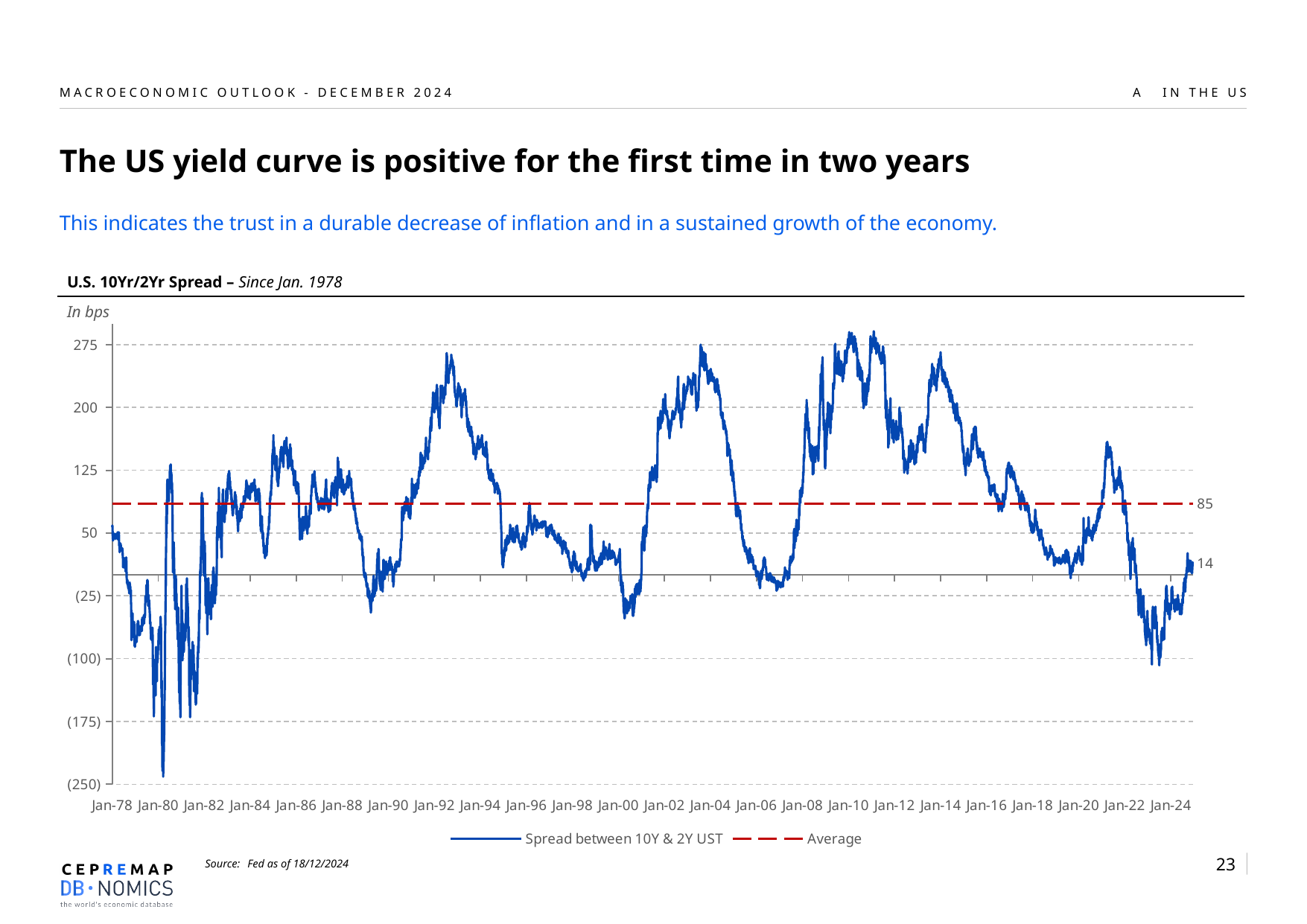
What is the value of the Average line labelled on the chart? 85 What is the title of the chart? U.S. 10Yr/2Yr Spread – Since Jan. 1978 Is the lowest value of the spread, reached around Jan-80, greater or less than (175)? less What kind of chart is shown on the slide? line chart What is the latest value of the spread between 10Y & 2Y UST labelled at the right end of the chart? 14 What is the difference between the Average (85) and the latest spread value (14)? 71 Between Jan-16 and Jan-18, does the spread generally rise or fall? fall Is the peak of the spread around Jan-10 greater or less than 200? greater How many series does the legend list? 2 Is the trough of the spread around Jan-23 greater or less than (25)? less In what unit are the values on the chart expressed? bps Which is larger, the Average value or the latest spread value? Average